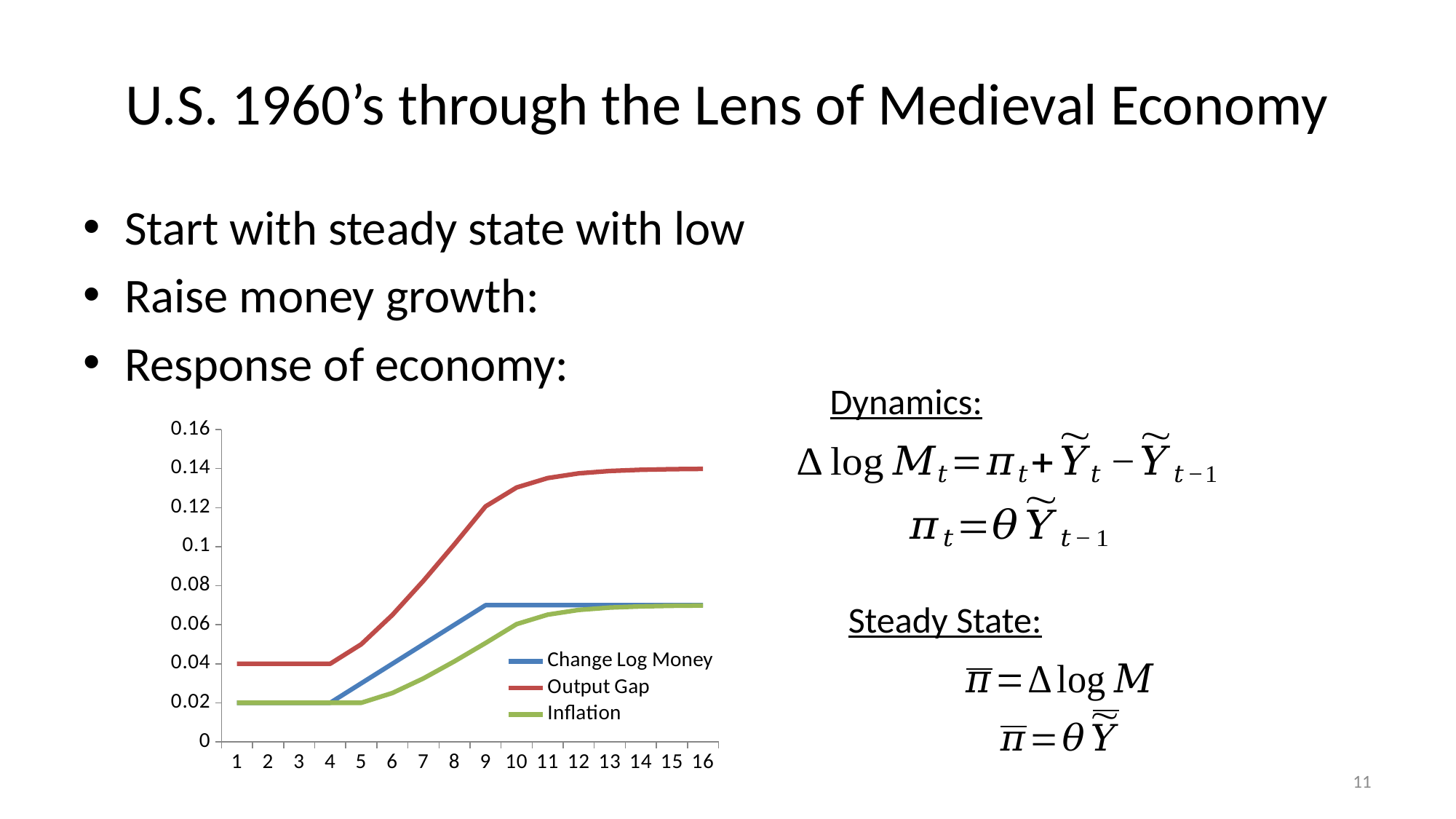
What is the value of Change Log Money at period 1? 0.02 Does the Output Gap series rise or fall from period 4 to period 16? rise Is the value of Change Log Money at period 16 greater or less than 0.06? greater What type of chart is shown on the slide? line chart How many periods are shown on the x axis of the chart? 16 At period 10, which is larger: Output Gap or Change Log Money? Output Gap Which series has the highest value at period 16? Output Gap What is the value of Output Gap at period 16? 0.14 Which series has the lowest value at period 8? Inflation What is the value of Output Gap at period 1? 0.04 Is the value of Inflation at period 8 greater or less than 0.06? less How many series does the chart legend list? 3